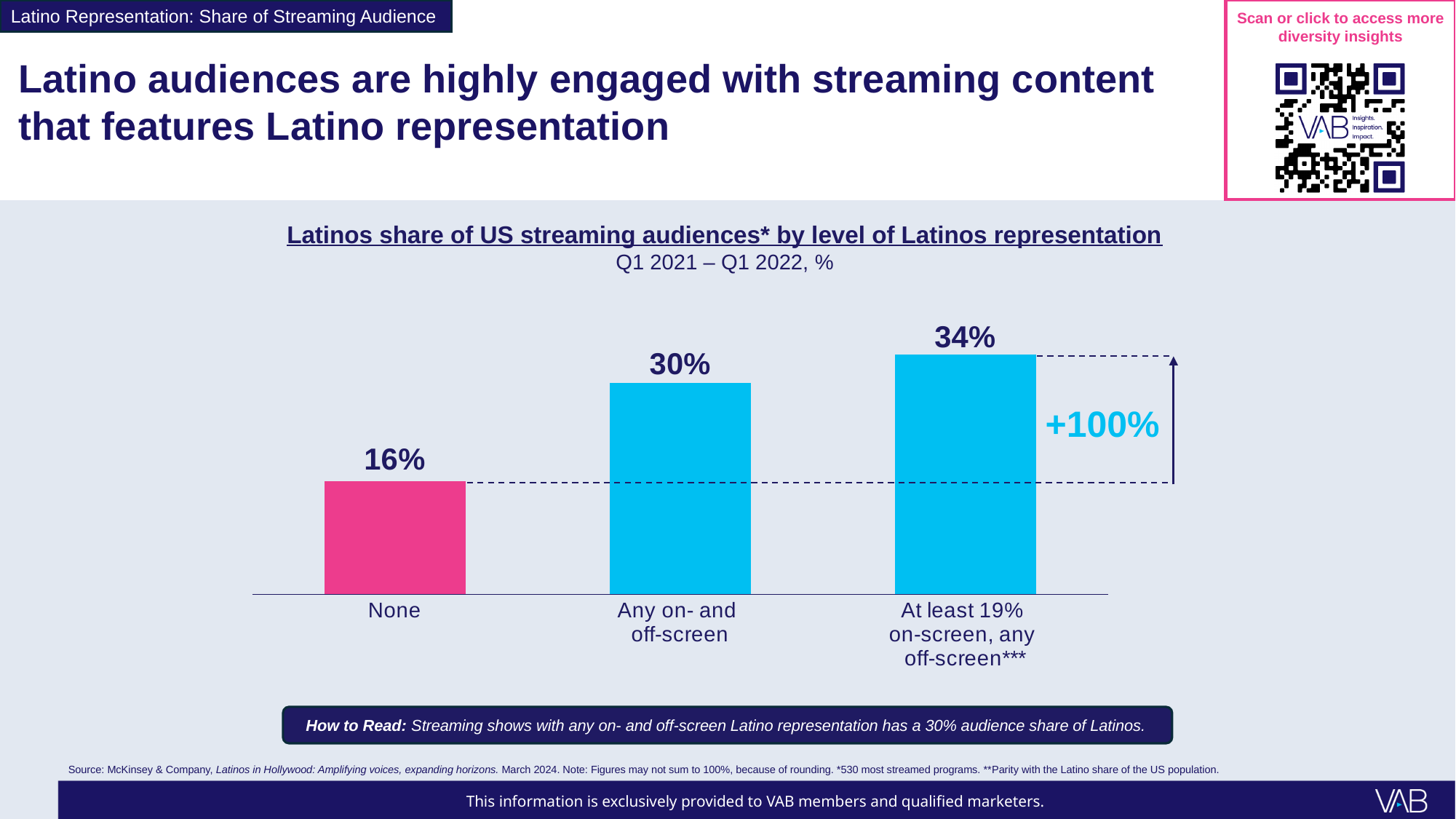
What type of chart is used to show Latino share of US streaming audiences by level of representation? Bar chart What is the Latino share of US streaming audiences for programs with any on- and off-screen Latino representation? 30% What is the difference in Latino audience share between 'At least 19% on-screen, any off-screen' and 'None'? 18 percentage points What is the difference in Latino audience share between 'Any on- and off-screen' and 'None'? 14 percentage points Which level of Latino representation has the lowest Latino share of streaming audiences? None Do the values rise or fall as the level of Latino representation increases from left to right? Rise How many levels of Latino representation are shown in the chart? 3 What is the Latino share of US streaming audiences for programs with no Latino representation (None)? 16% What is the Latino share of US streaming audiences for programs with at least 19% on-screen, any off-screen Latino representation? 34% Which level of Latino representation has the highest Latino share of streaming audiences? At least 19% on-screen, any off-screen Which has a larger Latino audience share: 'Any on- and off-screen' or 'None'? Any on- and off-screen What percentage change is annotated between the 'None' bar and the 'At least 19% on-screen, any off-screen' bar? +100%